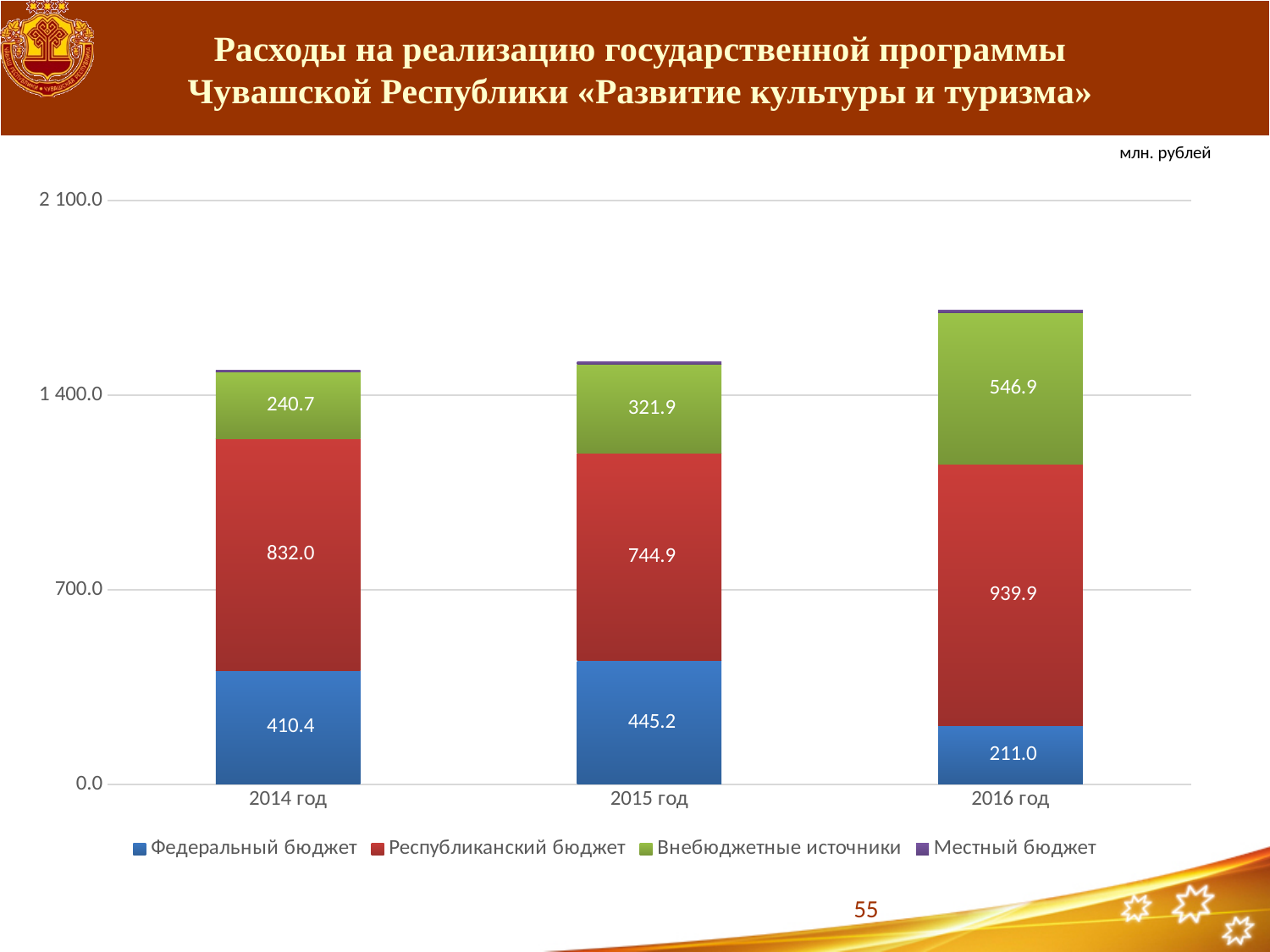
What is the value for Федеральный бюджет in 2014 год? 410.4 What is the difference between the Республиканский бюджет values for 2016 год and 2015 год? 195.0 What is the value for Внебюджетные источники in 2015 год? 321.9 Is the total height of the 2016 год bar greater or less than 1 400.0? greater Which is larger: Федеральный бюджет in 2015 год or Федеральный бюджет in 2014 год? 2015 год What is the value for Республиканский бюджет in 2016 год? 939.9 How many series does the legend list? 4 How many years are shown on the x axis? 3 What kind of chart is shown on the slide? Stacked bar chart In which year is the Внебюджетные источники value highest? 2016 год What is the difference between the Внебюджетные источники values for 2016 год and 2014 год? 306.2 In which year is the Федеральный бюджет value lowest? 2016 год